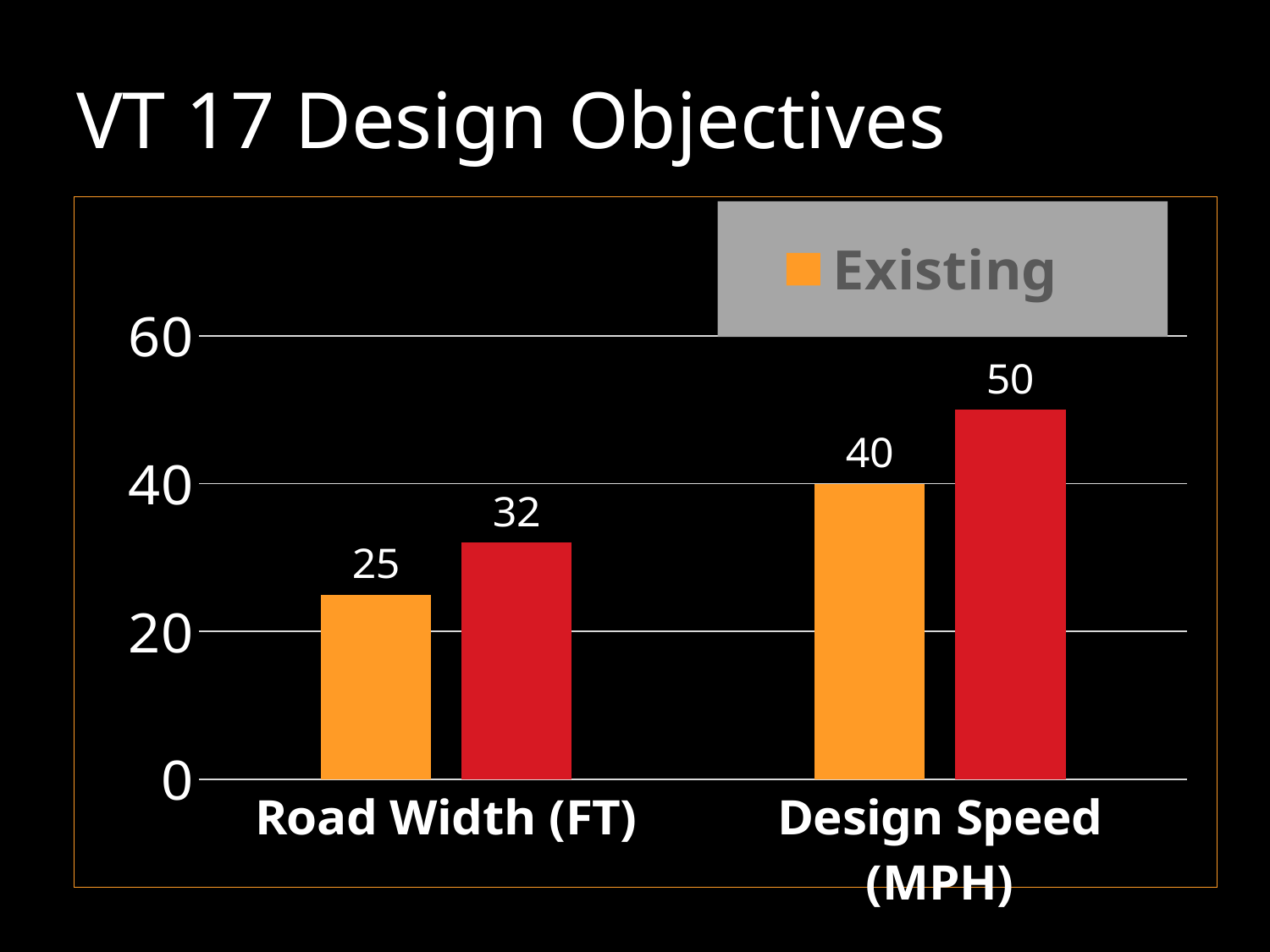
What is the Existing value for Road Width (FT)? 25 Which category has the larger Existing value, Road Width (FT) or Design Speed (MPH)? Design Speed (MPH) What is the highest value labelled on the chart? 50 How many categories are shown on the x axis? 2 For Design Speed (MPH), how much higher is the red bar than the Existing bar? 10 What is the title of the slide? VT 17 Design Objectives What kind of chart is shown on the slide? Bar chart What value is labelled on the red bar for Design Speed (MPH)? 50 What is the lowest value labelled on the chart? 25 What value is labelled on the red bar for Road Width (FT)? 32 For Road Width (FT), what is the difference between the red bar and the Existing bar? 7 What is the Existing value for Design Speed (MPH)? 40